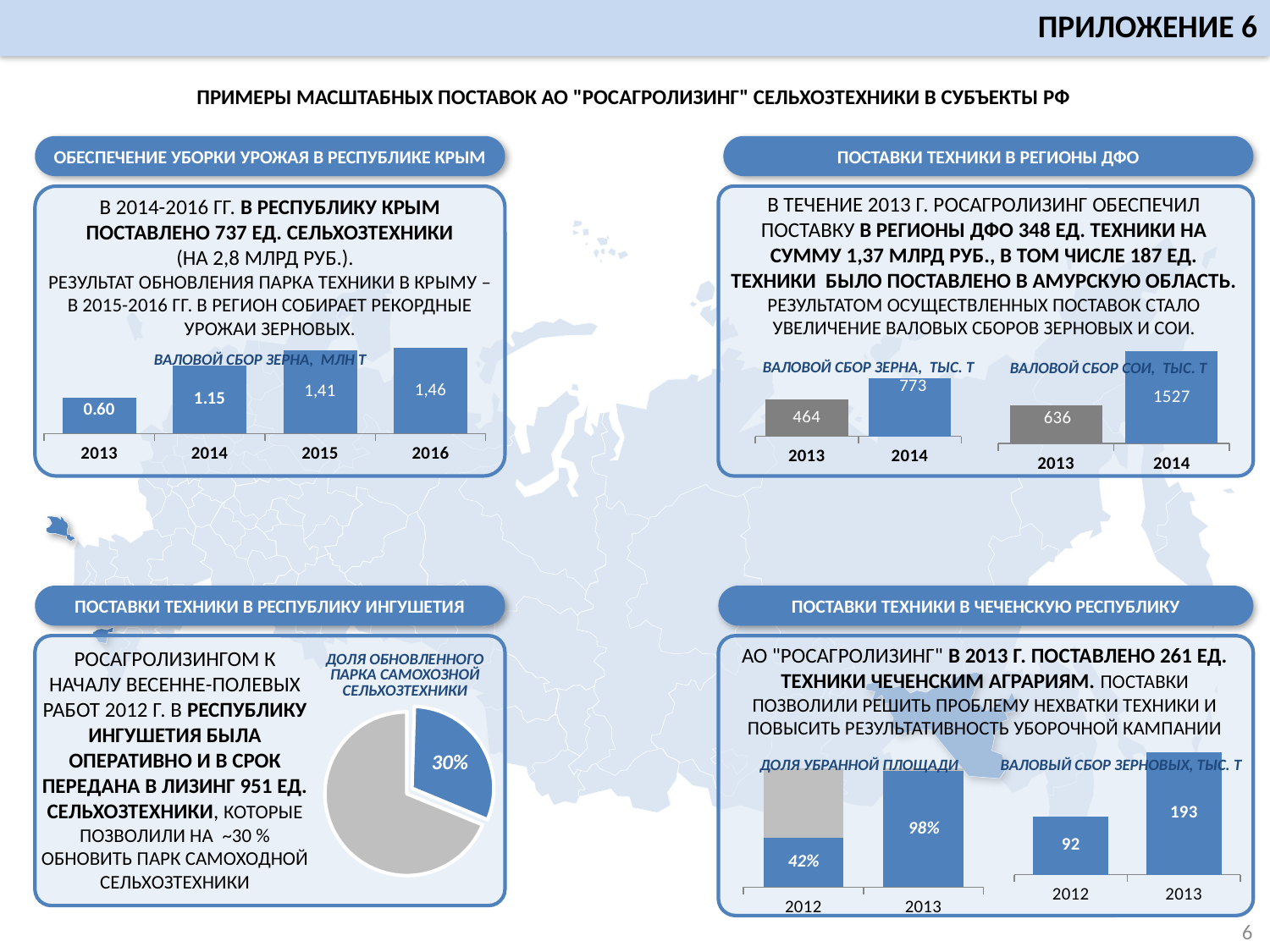
In the Chechnya chart "ДОЛЯ УБРАННОЙ ПЛОЩАДИ", what is the value for 2012? 42% In the DFO chart "ВАЛОВОЙ СБОР СОИ, ТЫС. Т", what is the value for 2013? 636 In the Crimea chart "ВАЛОВОЙ СБОР ЗЕРНА, МЛН Т", do the values rise or fall from 2013 to 2016? rise In the DFO chart "ВАЛОВОЙ СБОР ЗЕРНА, ТЫС. Т", what is the difference between 2014 and 2013? 309 In the Chechnya chart "ВАЛОВЫЙ СБОР ЗЕРНОВЫХ, ТЫС. Т", what is the difference between 2013 and 2012? 101 In the Crimea chart "ВАЛОВОЙ СБОР ЗЕРНА, МЛН Т", how many years are shown? 4 What type of chart is used for "ДОЛЯ ОБНОВЛЕННОГО ПАРКА САМОХОДНОЙ СЕЛЬХОЗТЕХНИКИ" in the Ingushetia block? pie chart In the Crimea chart "ВАЛОВОЙ СБОР ЗЕРНА, МЛН Т", which year has the highest value? 2016 In the DFO chart "ВАЛОВОЙ СБОР ЗЕРНА, ТЫС. Т", what is the value for 2014? 773 In the DFO chart "ВАЛОВОЙ СБОР СОИ, ТЫС. Т", which year is larger, 2013 or 2014? 2014 In the Ingushetia pie chart "ДОЛЯ ОБНОВЛЕННОГО ПАРКА САМОХОДНОЙ СЕЛЬХОЗТЕХНИКИ", what share is labelled on the blue slice? 30% In the Crimea chart "ВАЛОВОЙ СБОР ЗЕРНА, МЛН Т", what is the value for 2013? 0.60